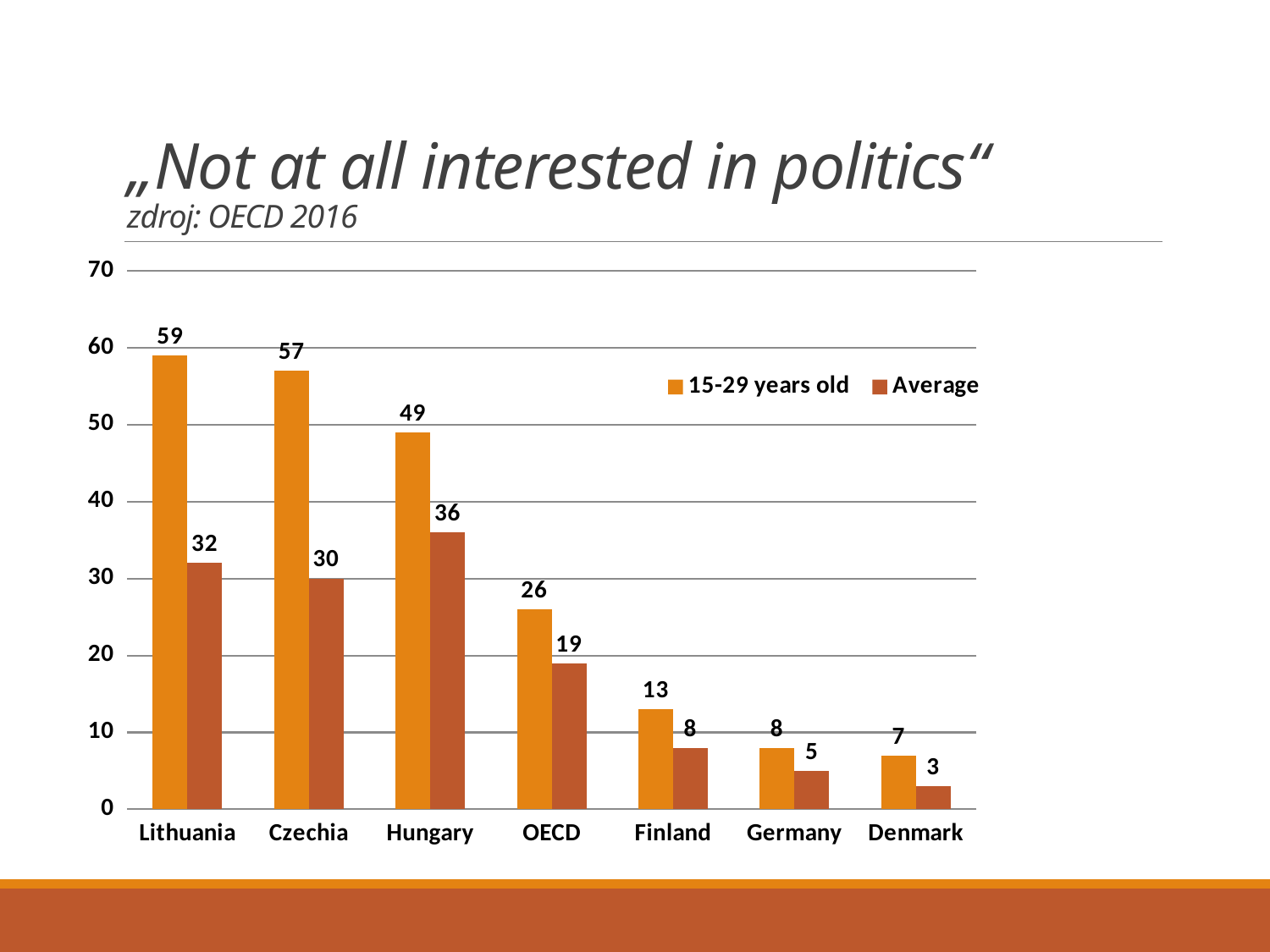
How many series does the legend list? 2 What kind of chart is shown on the slide? bar chart What is the value for 15-29 years old in Finland? 13 How many categories are shown on the x axis? 7 What is the difference between the 15-29 years old value and the Average value for Lithuania? 27 Which category has the highest value for 15-29 years old? Lithuania What is the value for 15-29 years old in Czechia? 57 Which category has the lowest Average value? Denmark What is the title of the chart? „Not at all interested in politics“ Do the 15-29 years old values rise or fall from Lithuania to Denmark along the x axis? fall What is the Average value for Hungary? 36 Which is larger: the Average value for Czechia or the Average value for Hungary? Hungary